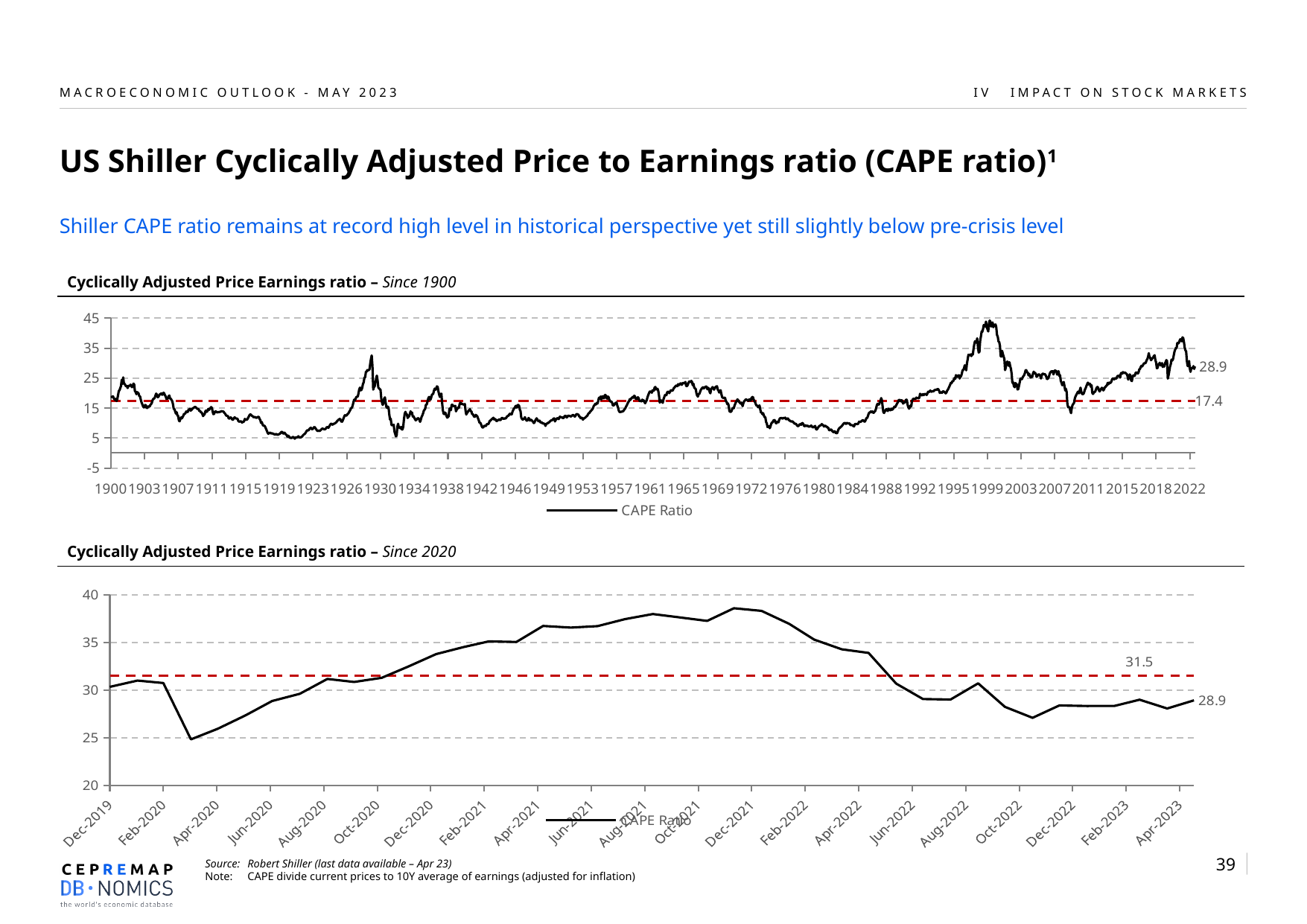
In the 'Since 1900' chart, what value is labelled on the red dashed horizontal line? 17.4 In the 'Since 2020' chart, what value is labelled on the red dashed horizontal line? 31.5 How many series does the legend of the 'Since 1900' chart list? 1 In the 'Since 2020' chart, which is larger: the dashed-line value or the latest CAPE ratio value? the dashed-line value (31.5) In the 'Since 2020' chart, what is the latest CAPE ratio value labelled at the end of the line? 28.9 In the 'Since 1900' chart, is the CAPE ratio around 1999 greater or less than 35? greater What kind of chart is the 'Cyclically Adjusted Price Earnings ratio – Since 1900' chart? line chart What is the name of the series shown in the legend of the 'Since 2020' chart? CAPE Ratio In the 'Since 1900' chart, is the CAPE ratio around 1919 greater or less than 15? less In the 'Since 1900' chart, what is the latest CAPE ratio value labelled at the end of the line? 28.9 In the 'Since 1900' chart, what is the difference between the latest value (28.9) and the dashed-line value (17.4)? 11.5 In the 'Since 2020' chart, does the CAPE ratio rise or fall between Dec-2021 and Oct-2022? fall